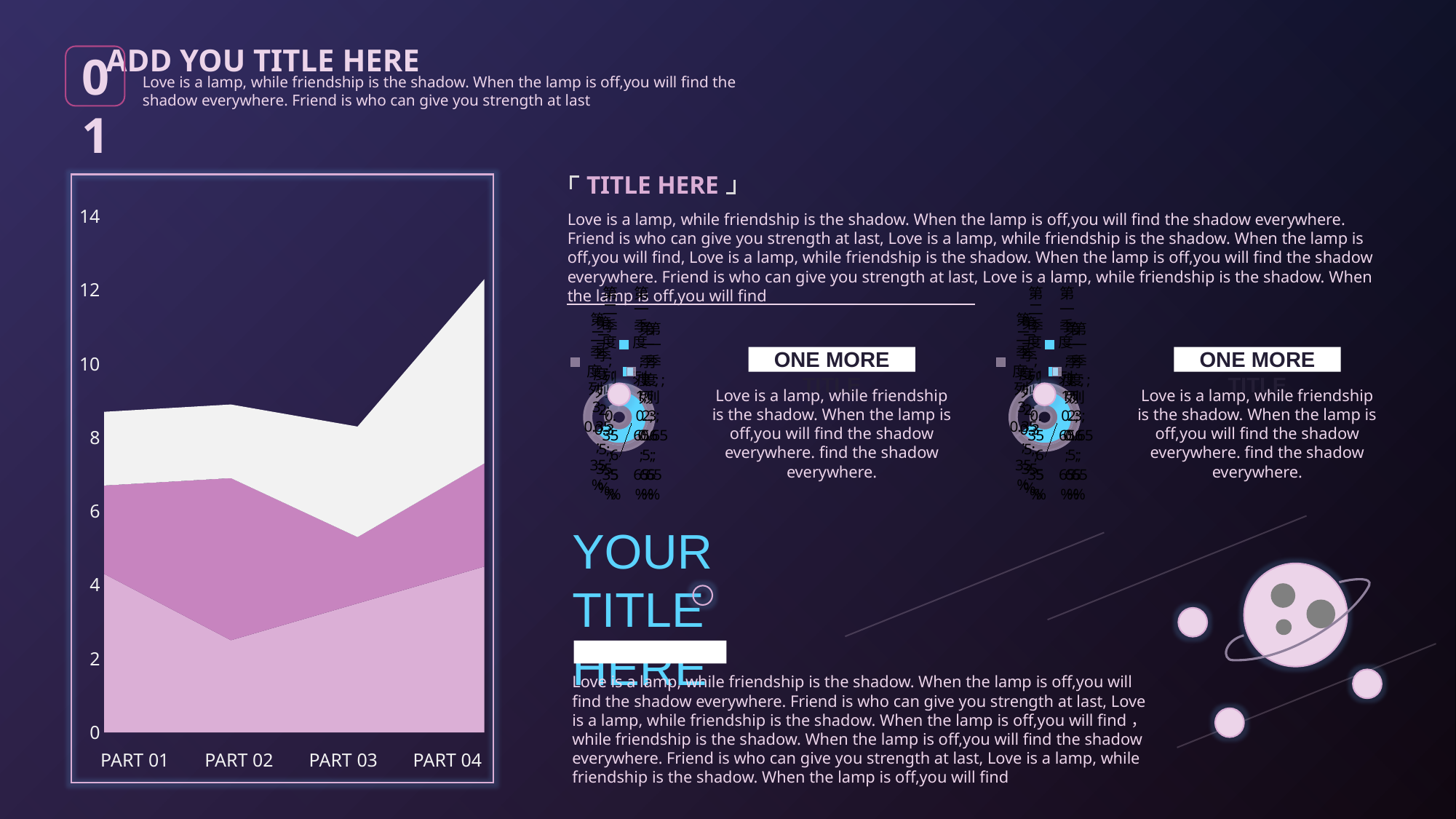
How many stacked series (coloured areas) are plotted in the area chart? 3 In the area chart, which category has the highest total stacked height? PART 04 In the area chart, does the total stacked height rise or fall from PART 03 to PART 04? rise What is the highest value labelled on the y axis of the area chart? 14 What kind of chart is shown on the left of the slide? Stacked area chart In the area chart, is the value of the bottom (light pink) series at PART 02 greater or less than 4? less In the area chart, which category has the lowest value for the bottom (light pink) series? PART 02 How many categories are shown on the x axis of the area chart? 4 In the area chart, is the total stacked height larger at PART 04 or at PART 02? PART 04 In the area chart, is the total stacked height at PART 01 greater or less than 10? less In the area chart, is the total stacked height at PART 04 greater or less than 10? greater